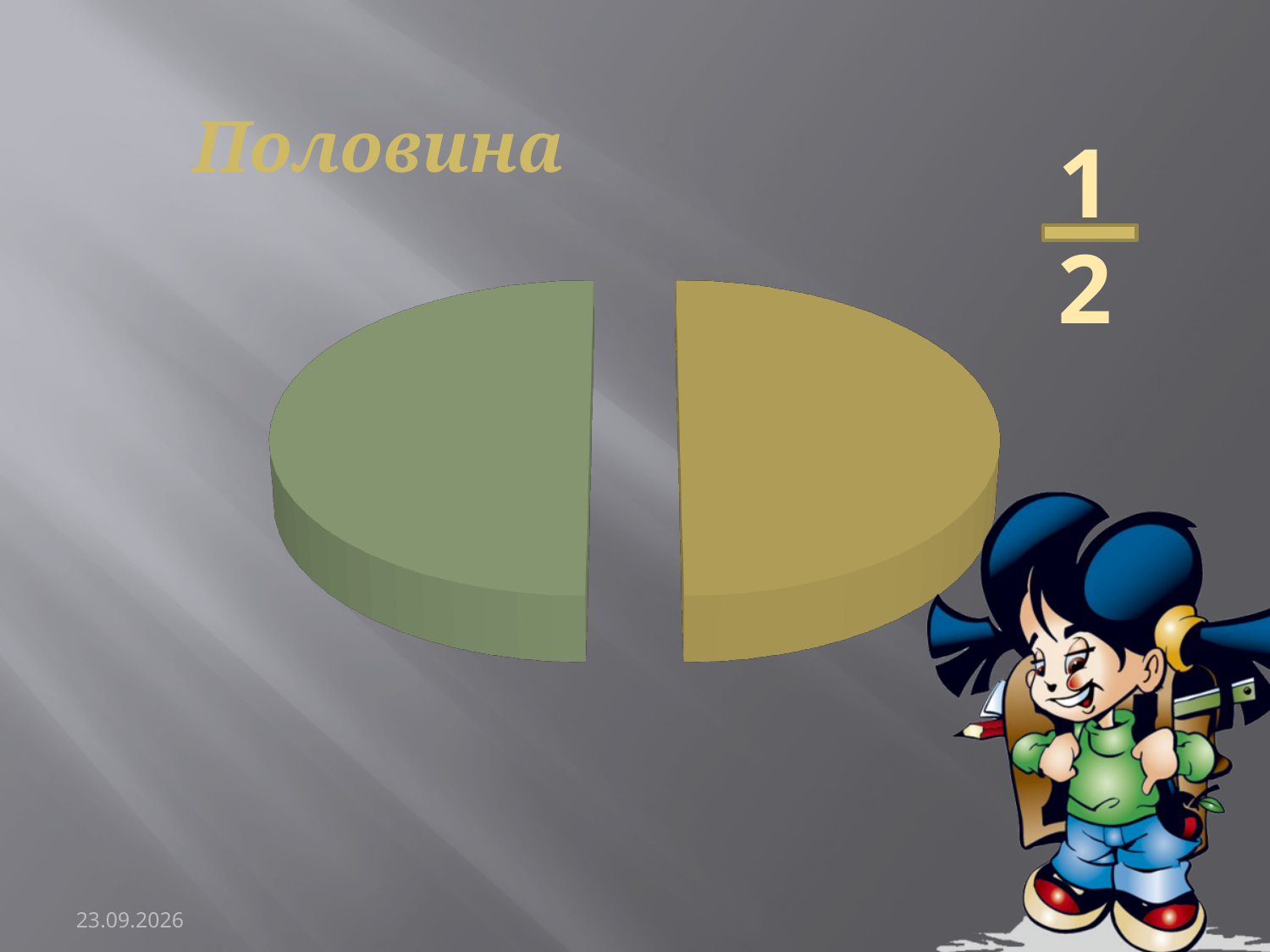
What colour is the right-hand slice of the pie chart? yellow-olive (gold) What kind of chart is shown on the slide? pie chart What is the title text shown above the pie chart? Половина How many slices does the pie chart have? 2 Are the two slices of the pie chart equal in size? yes What fraction of the pie does each slice represent, according to the fraction printed on the slide? 1/2